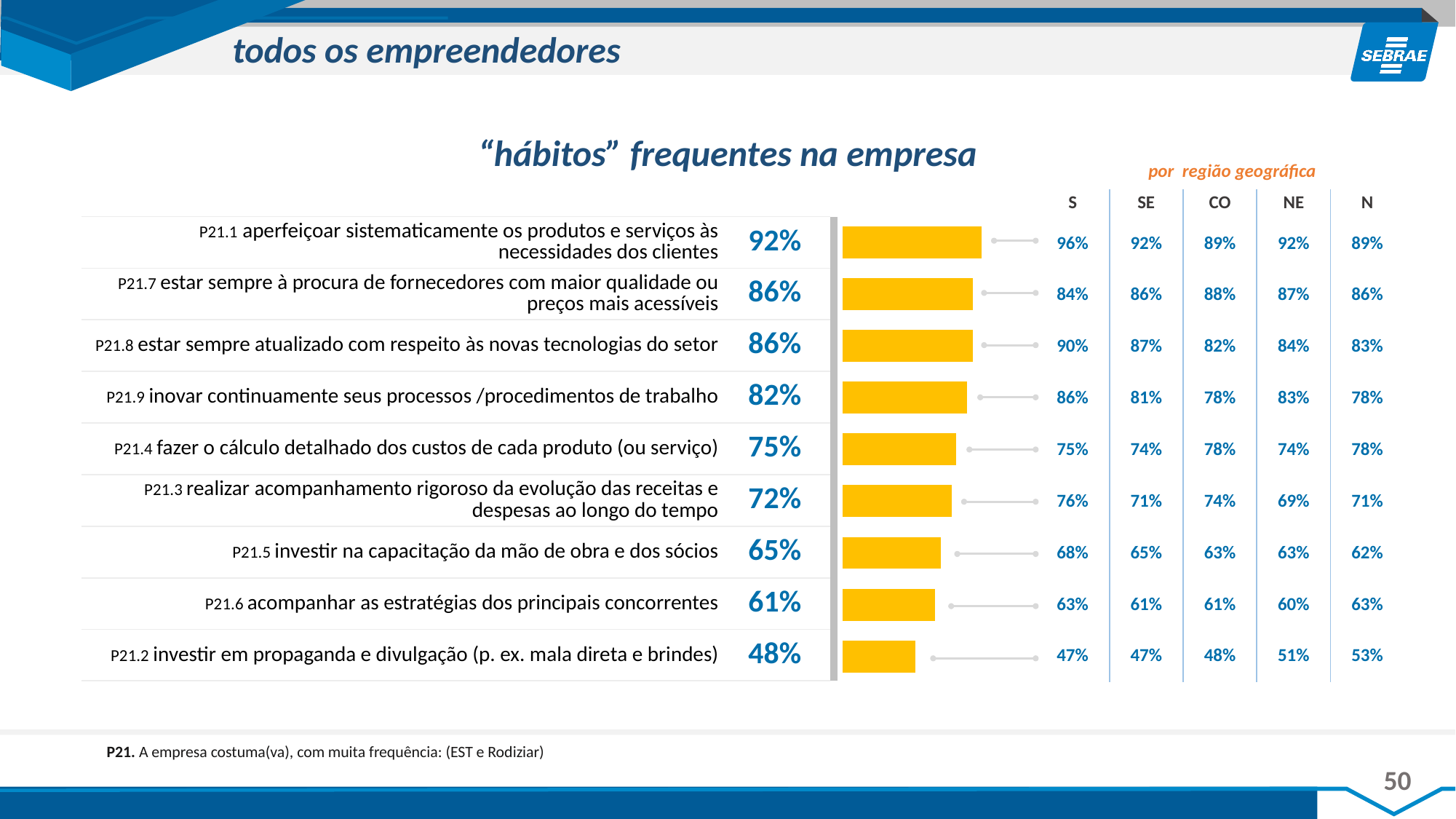
What kind of chart is used to show the habit percentages? Bar chart What colour are the bars in the chart? Yellow What is the value for P21.5 (investir na capacitação da mão de obra e dos sócios)? 65% What is the value for P21.1 (aperfeiçoar sistematicamente os produtos e serviços às necessidades dos clientes)? 92% Which is larger, the value for P21.4 (fazer o cálculo detalhado dos custos) or the value for P21.3 (realizar acompanhamento rigoroso da evolução das receitas e despesas)? P21.4 Which habit has the highest value in the bar chart? P21.1 aperfeiçoar sistematicamente os produtos e serviços às necessidades dos clientes In the regional table, what is the value for P21.2 in region N? 53% Do the bar values increase or decrease from the top of the chart to the bottom? Decrease In the regional table, what is the value for P21.1 in region S? 96% What is the difference between the value for P21.1 and the value for P21.2? 44% How many habits (bars) are shown in the chart? 9 Which habit has the lowest value in the bar chart? P21.2 investir em propaganda e divulgação (p. ex. mala direta e brindes)